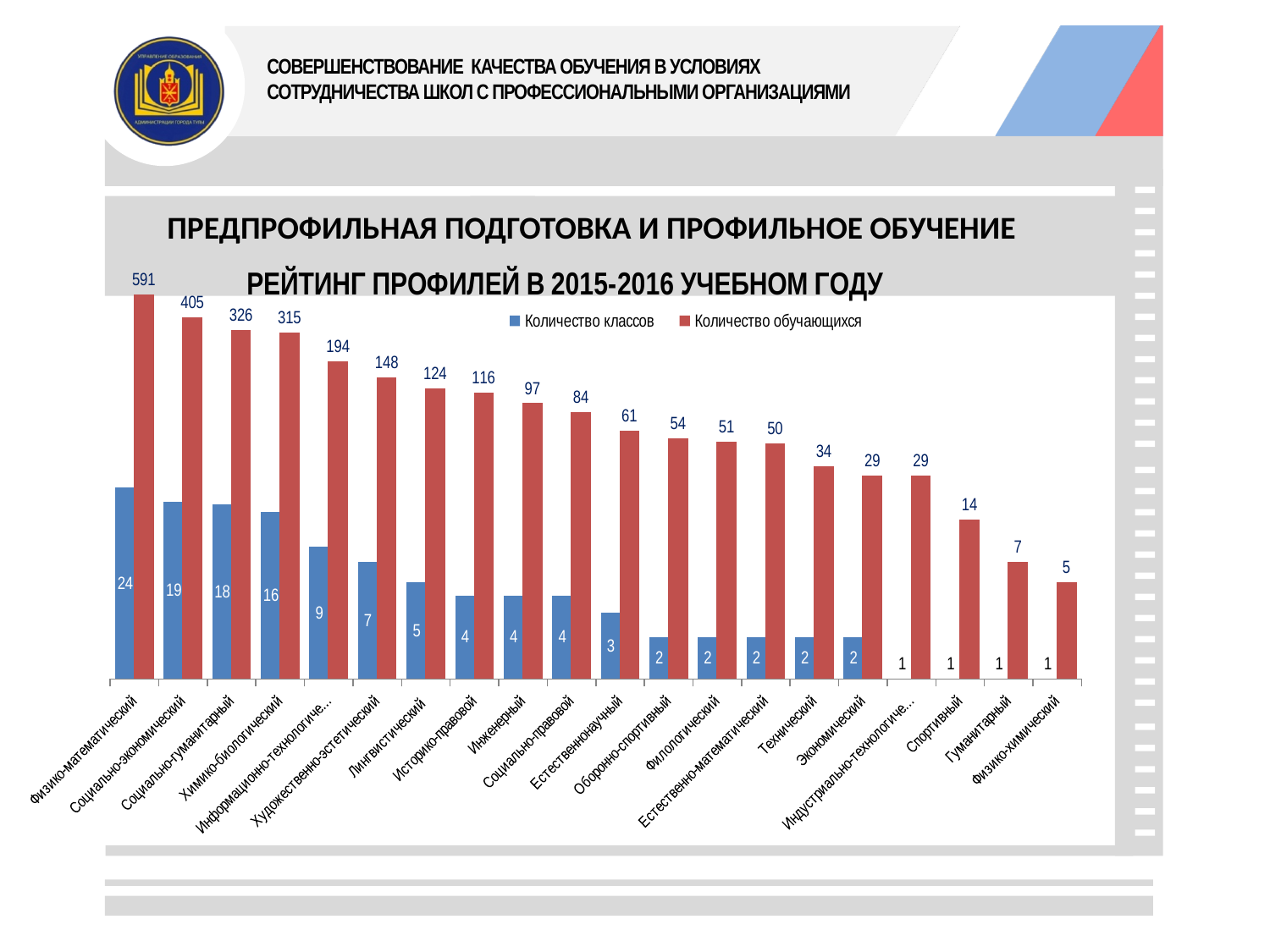
Do the values of Количество обучающихся rise or fall from left to right along the x axis? fall How many series does the legend list? 2 What is the value of Количество обучающихся for Лингвистический? 124 Which category has the lowest value of Количество обучающихся? Физико-химический What colour are the bars for Количество обучающихся? red What type of chart is shown on the slide? bar chart Which is larger: Количество обучающихся for Инженерный or for Социально-правовой? Инженерный What is the difference in Количество обучающихся between Социально-экономический and Социально-гуманитарный? 79 What is the value of Количество обучающихся for Физико-математический? 591 Which category has the highest value of Количество обучающихся? Физико-математический How many profile categories are shown on the x axis? 20 What is the value of Количество классов for Химико-биологический? 16